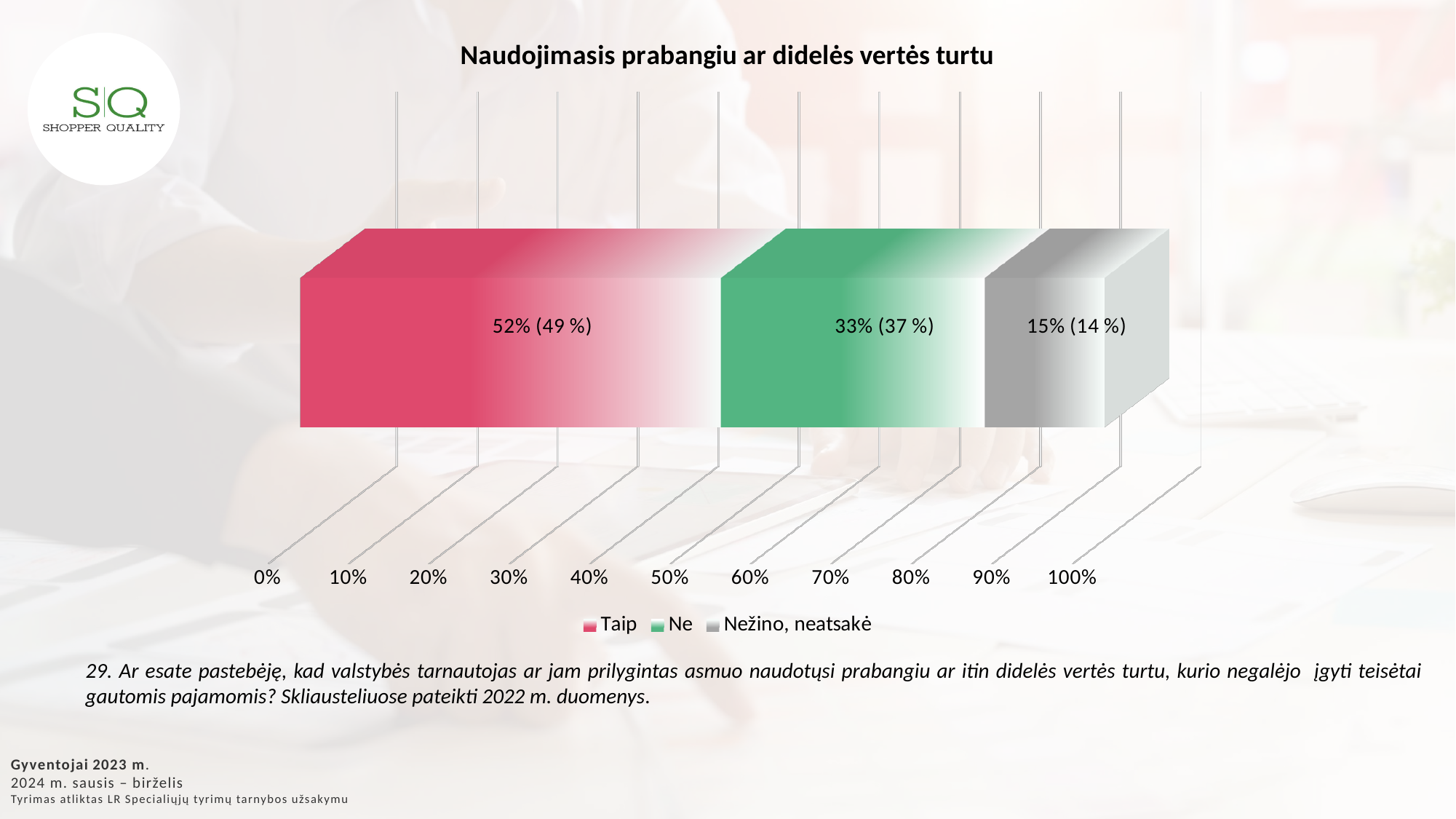
Which is larger, the value for "Ne" or the value for "Nežino, neatsakė"? Ne What kind of chart is shown on the slide? Stacked bar chart What is the value for "Taip" in the chart? 52% How many series does the legend list? 3 What is the title of the chart? Naudojimasis prabangiu ar didelės vertės turtu What was the 2022 value for "Taip", shown in parentheses on the chart? 49 % What was the 2022 value for "Ne", shown in parentheses on the chart? 37 % What is the value for "Nežino, neatsakė" in the chart? 15% What is the difference between the values for "Taip" and "Ne"? 19 percentage points What is the value for "Ne" in the chart? 33% Which series has the highest value in the chart? Taip Which series has the lowest value in the chart? Nežino, neatsakė